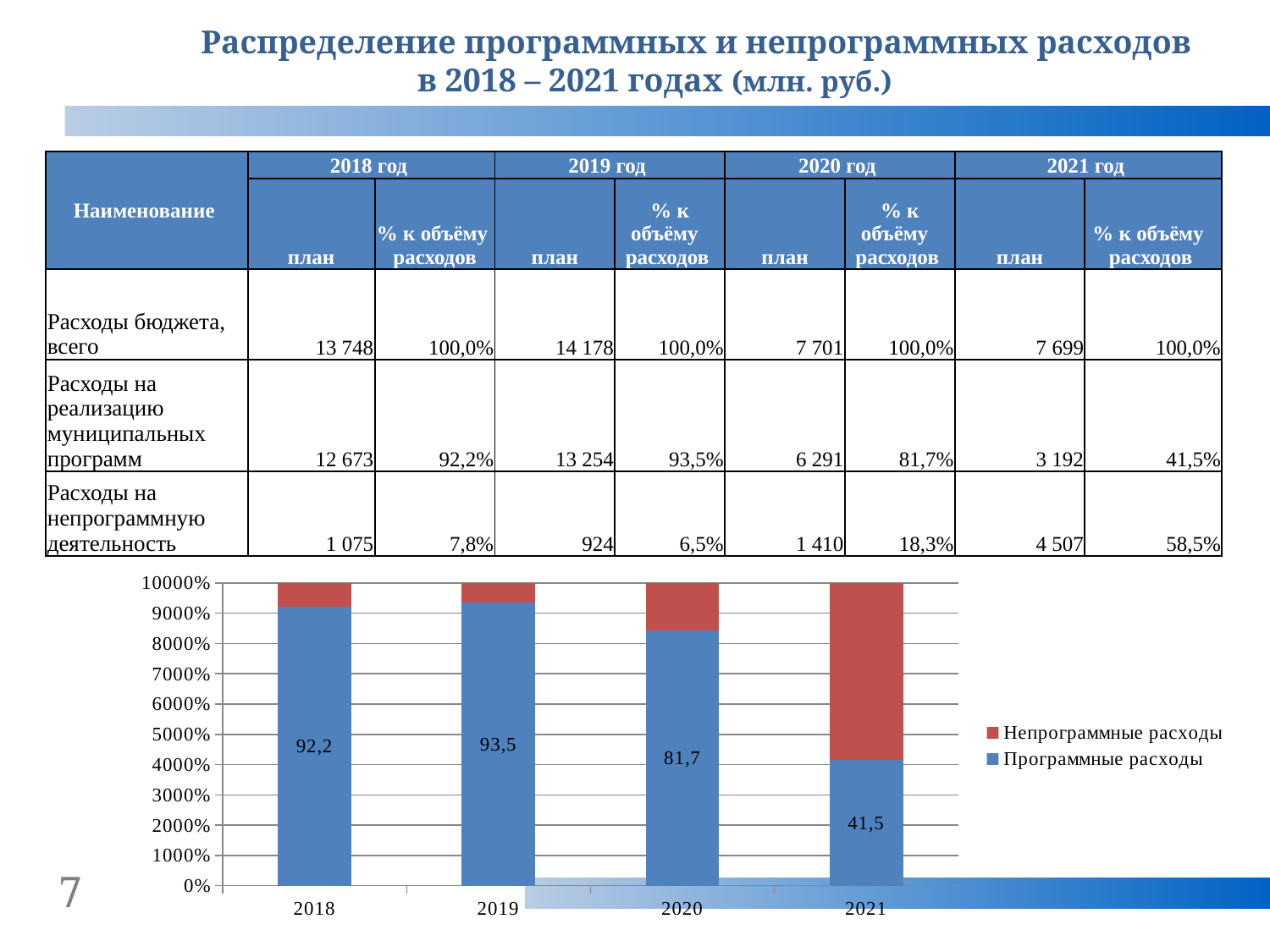
What type of chart is shown on the slide? stacked bar chart In which year is the labelled value for Программные расходы the lowest? 2021 Which year has the larger Программные расходы label, 2018 or 2020? 2018 In which year is the labelled value for Программные расходы the highest? 2019 What is the data label for Программные расходы in 2018? 92,2 What is the data label for Программные расходы in 2020? 81,7 What is the data label for Программные расходы in 2021? 41,5 What is the difference between the Программные расходы labels for 2019 and 2021? 52,0 What is the data label for Программные расходы in 2019? 93,5 How many years are shown on the x axis of the chart? 4 How many series does the chart legend list? 2 Which series is shown in red in the chart? Непрограммные расходы